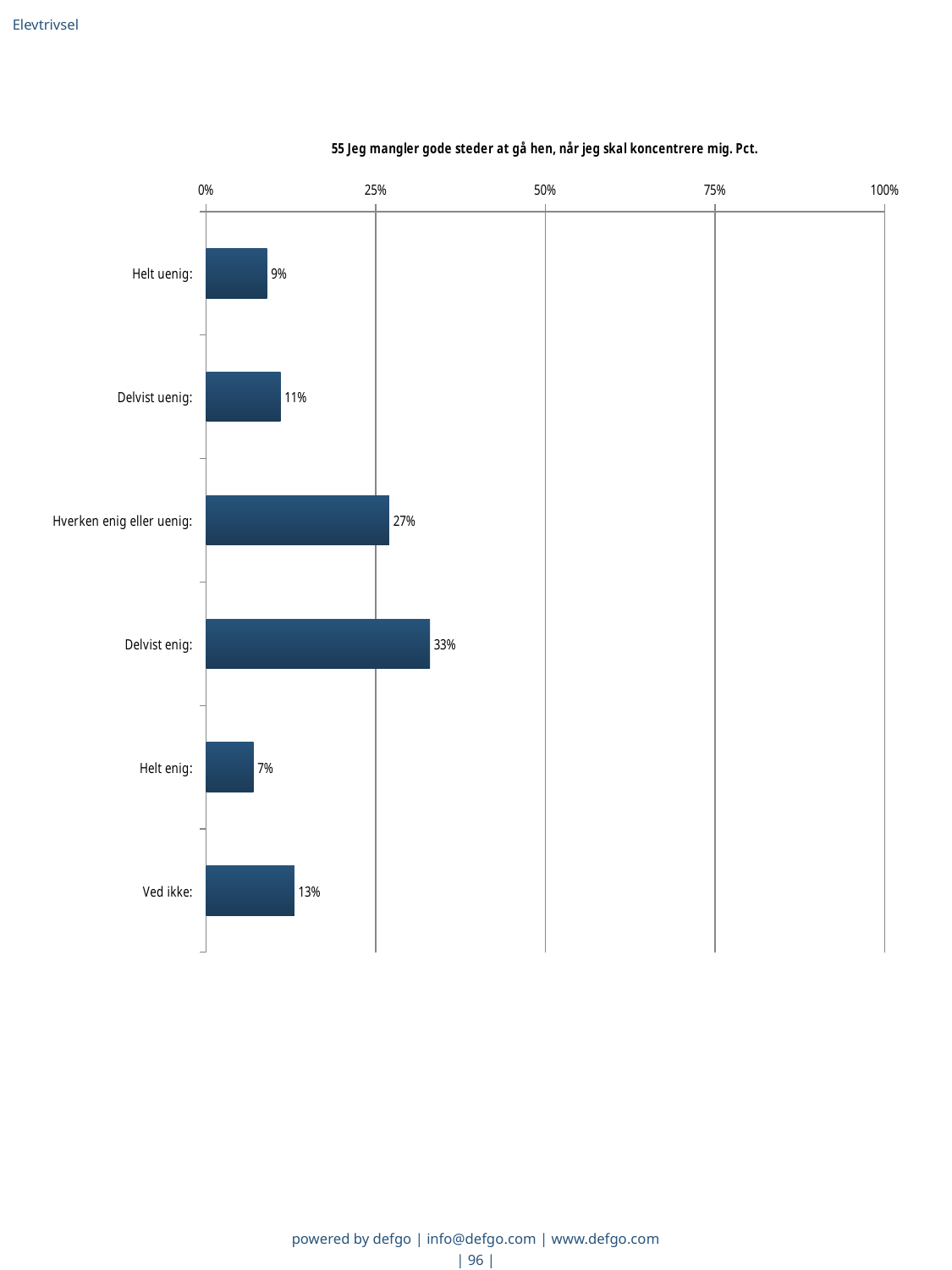
Which is larger, the value for "Delvist uenig" or the value for "Ved ikke"? Ved ikke Is the value for "Hverken enig eller uenig" greater or less than 25%? greater What is the value for "Delvist enig"? 33% What is the difference between the values for "Delvist enig" and "Hverken enig eller uenig"? 6% What is the value for "Ved ikke"? 13% What kind of chart is shown on the slide? bar chart How many categories are shown in the chart? 6 Which category has the highest value? Delvist enig Which category has the lowest value? Helt enig What is the difference between the values for "Ved ikke" and "Helt enig"? 6% What is the title of the chart? 55 Jeg mangler gode steder at gå hen, når jeg skal koncentrere mig. Pct. What is the value for "Helt uenig"? 9%